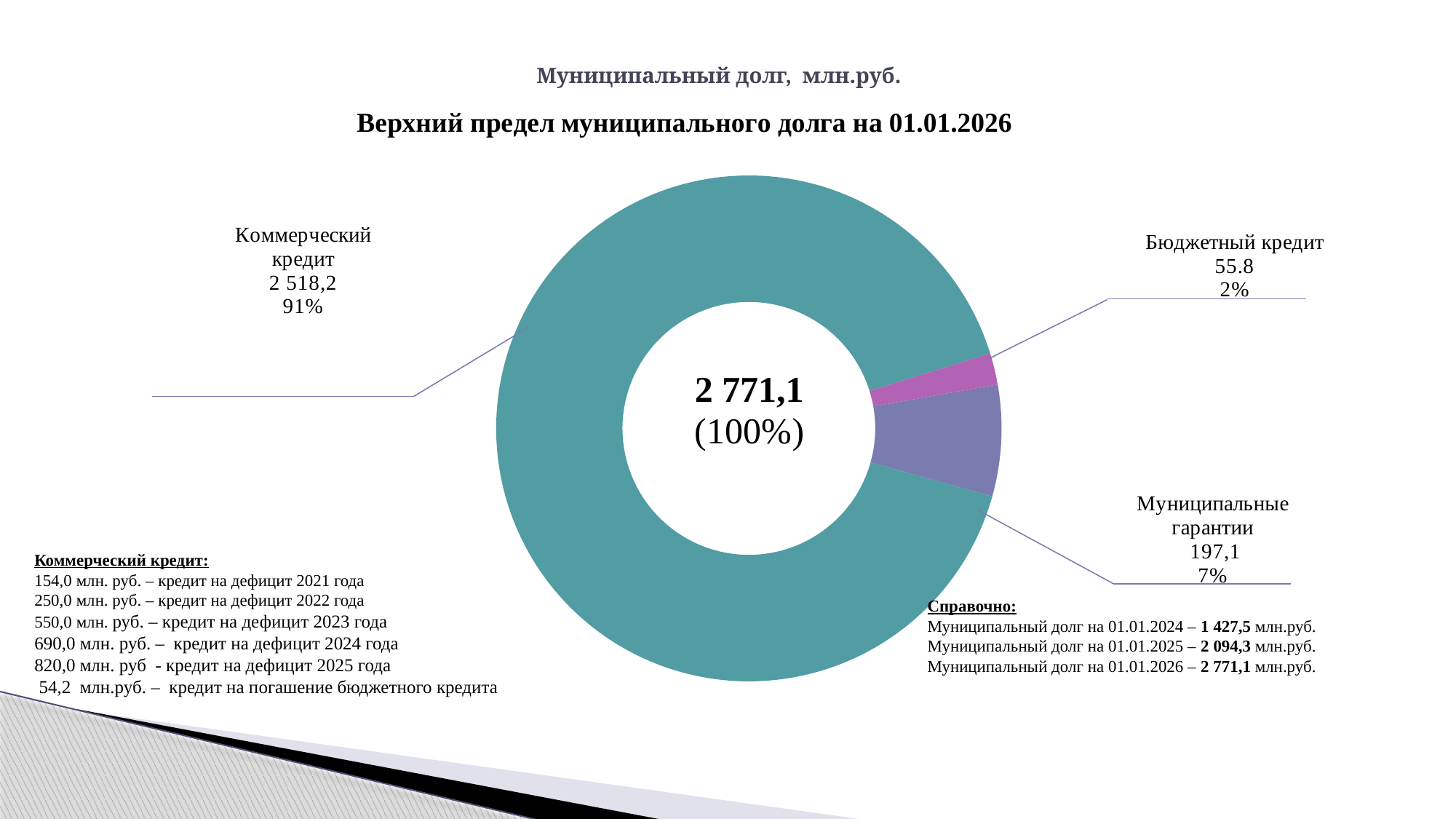
What share of the total does Муниципальные гарантии represent? 7% Which is larger, Муниципальные гарантии or Бюджетный кредит? Муниципальные гарантии Which category has the largest value? Коммерческий кредит What total value is shown in the centre of the chart? 2 771,1 Which category has the smallest value? Бюджетный кредит What kind of chart is shown on the slide? Donut (pie) chart What share of the total does Бюджетный кредит represent? 2% What is the value for Бюджетный кредит? 55.8 What is the value for Муниципальные гарантии? 197,1 How many categories does the chart show? 3 What share of the total does Коммерческий кредит represent? 91% What is the value for Коммерческий кредит? 2 518,2